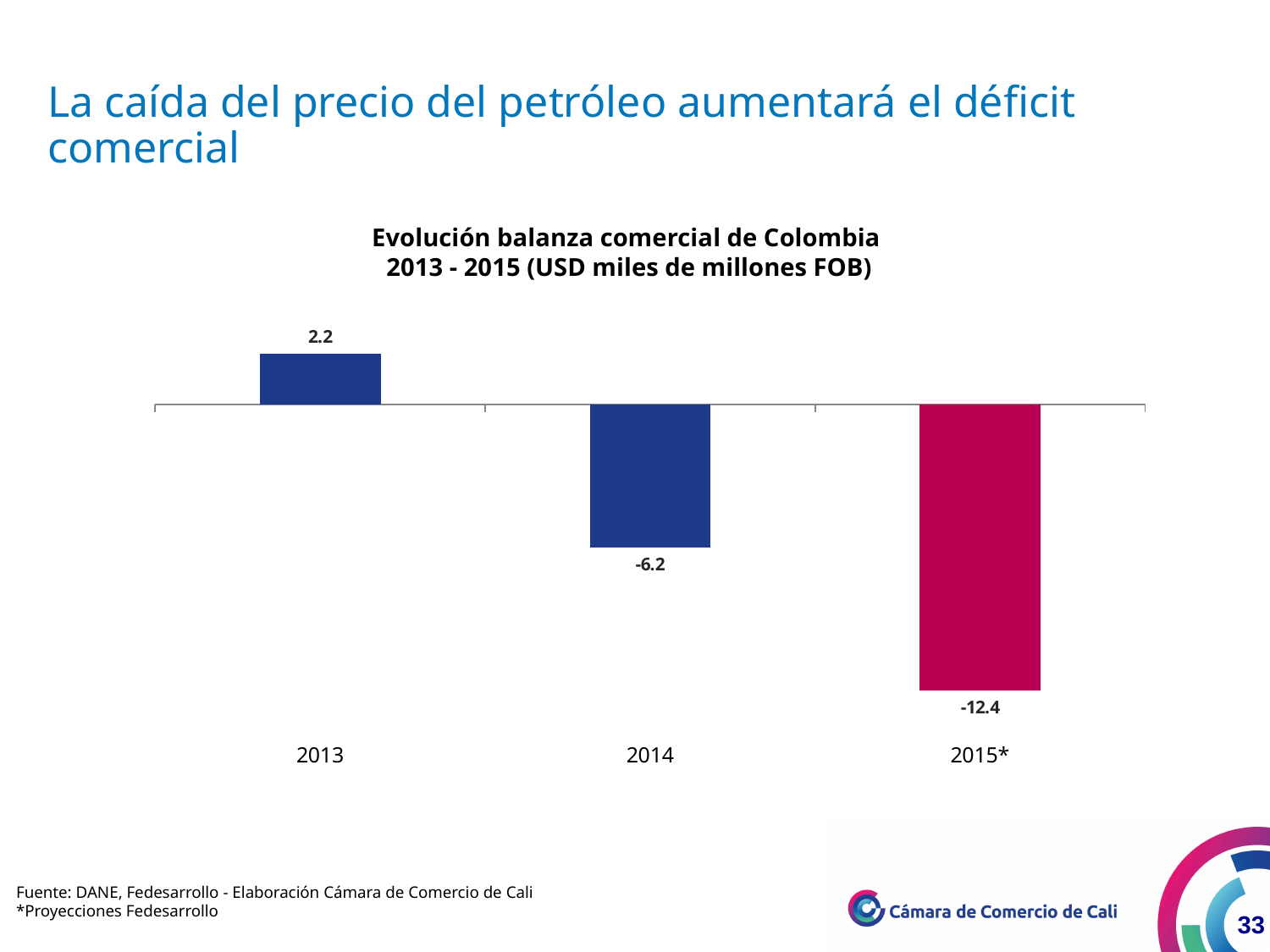
What is the difference between the values for 2013 and 2014? 8.4 How many years are shown in the chart? 3 What is the title of the chart? Evolución balanza comercial de Colombia 2013 - 2015 (USD miles de millones FOB) Which is larger, the value for 2014 or the value for 2015*? 2014 Which year has the lowest value? 2015* What is the value for 2015*? -12.4 Do the values rise or fall from 2013 to 2015*? Fall What is the value for 2014? -6.2 What is the value for 2013? 2.2 What kind of chart is this? Bar chart Which year has the highest value? 2013 What is the difference between the values for 2014 and 2015*? 6.2